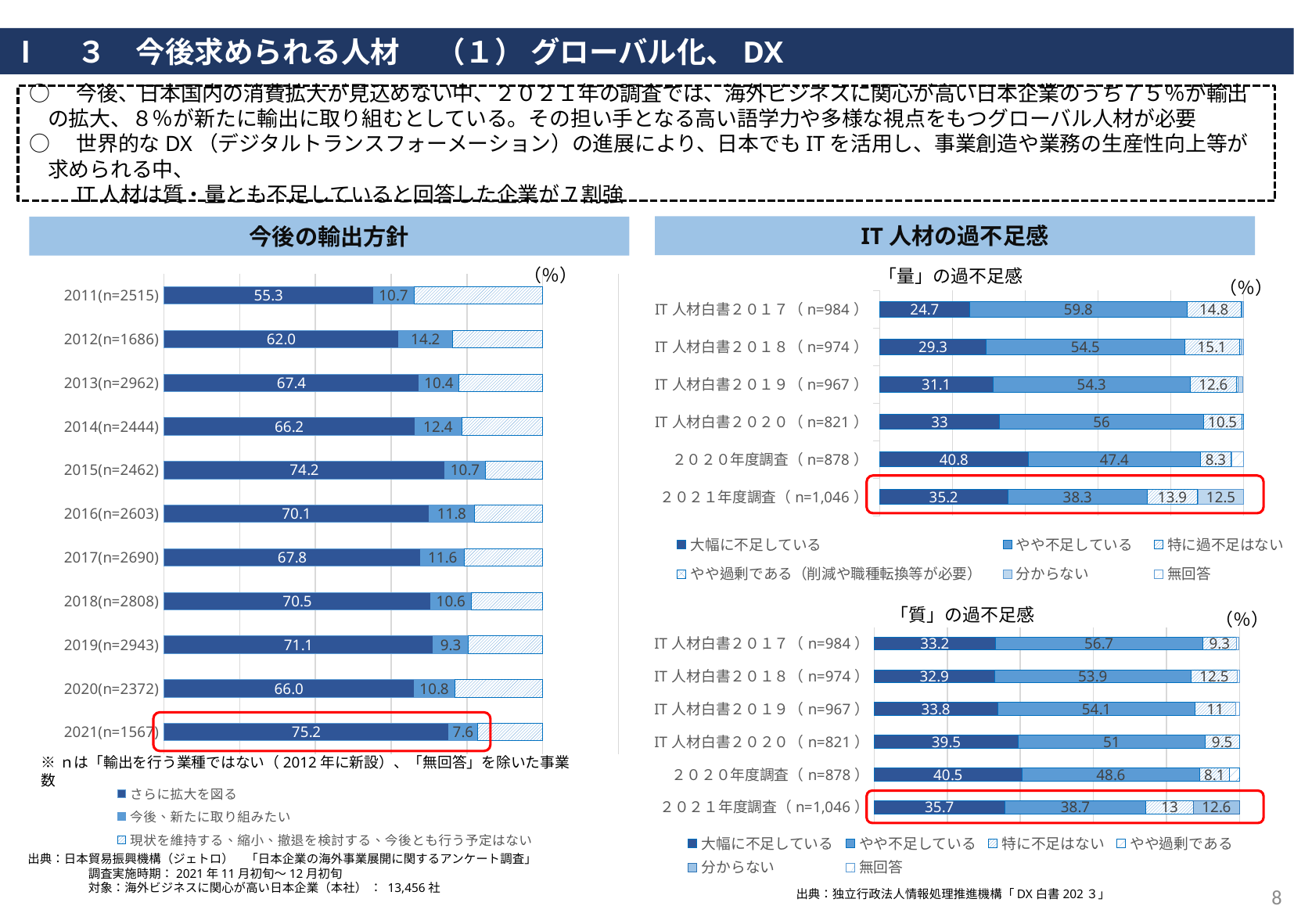
In the 「量」の過不足感 chart, what is the value of 大幅に不足している for ２０２１年度調査 (n=1,046)? 35.2 In the 「量」の過不足感 chart, how many series does the legend list? 6 In the 「質」の過不足感 chart, what is the value of 大幅に不足している for ２０２１年度調査 (n=1,046)? 35.7 In the 「量」の過不足感 chart, which survey has the highest value for 大幅に不足している? ２０２０年度調査 (n=878) What kind of chart is the 今後の輸出方針 chart? Stacked bar chart In the 今後の輸出方針 chart, what is the value of さらに拡大を図る for 2021(n=1567)? 75.2 In the 「量」の過不足感 chart, what is the difference between the 大幅に不足している values for ２０２０年度調査 (n=878) and ２０２１年度調査 (n=1,046)? 5.6 In the 今後の輸出方針 chart, how many series does the legend list? 3 In the 「質」の過不足感 chart, which is larger: the やや不足している value for IT人材白書２０１７ (n=984) or for ２０２１年度調査 (n=1,046)? IT人材白書２０１７ (n=984) In the 今後の輸出方針 chart, which year has the lowest value for さらに拡大を図る? 2011(n=2515) In the 今後の輸出方針 chart, what is the difference between the さらに拡大を図る values for 2021(n=1567) and 2011(n=2515)? 19.9 In the 今後の輸出方針 chart, how many years are shown on the vertical axis? 11